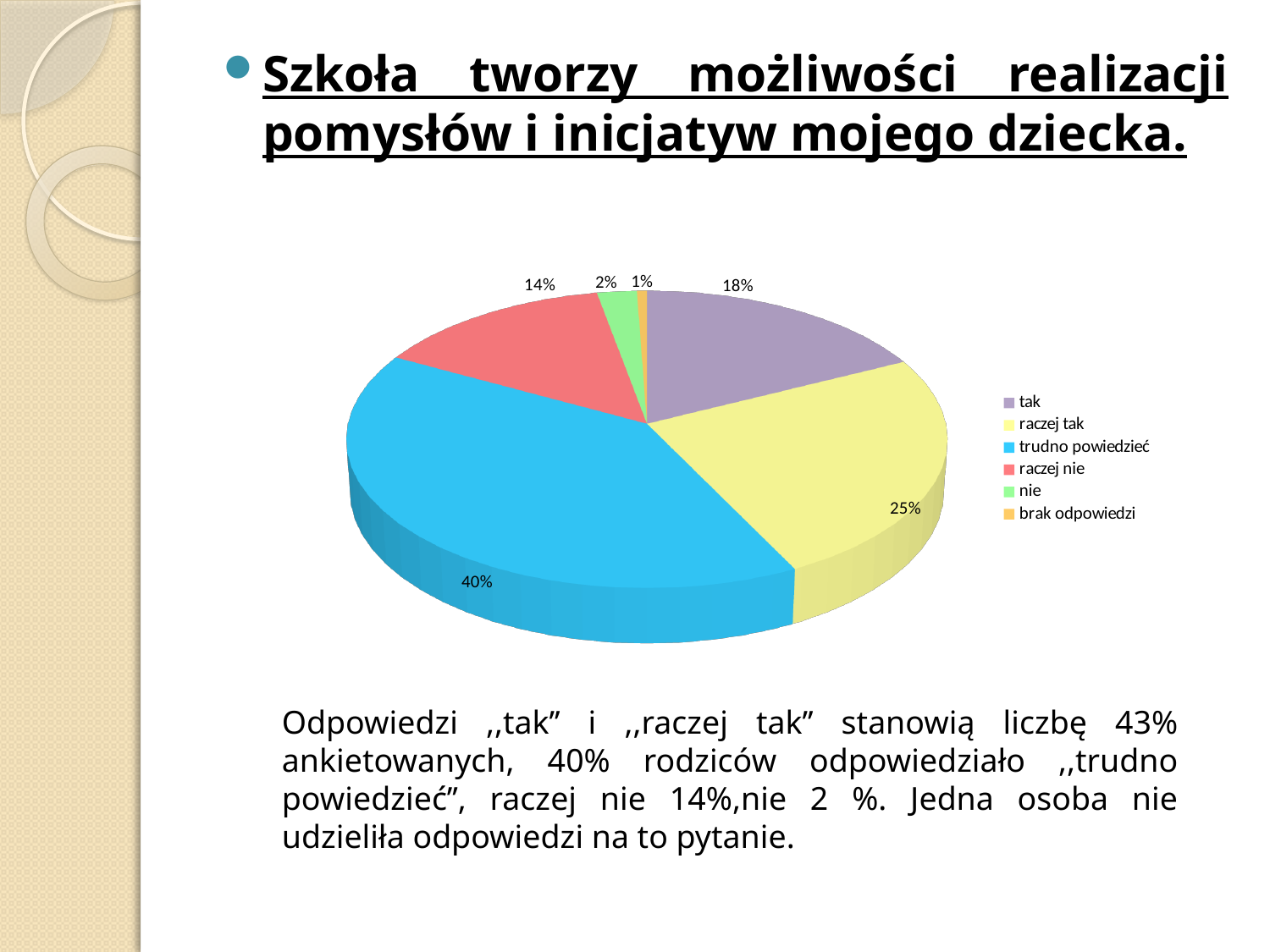
Which answer category has the largest share of the pie? trudno powiedzieć What is the difference in percentage points between "trudno powiedzieć" and "raczej tak"? 15 Which is larger, the share for "tak" or the share for "raczej nie"? tak How many categories does the legend list? 6 What percentage of respondents answered "trudno powiedzieć"? 40% What percentage is shown for "brak odpowiedzi"? 1% What percentage of respondents answered "nie"? 2% What kind of chart is shown on the slide? pie chart Which answer category has the smallest share of the pie? brak odpowiedzi What percentage of respondents answered "tak"? 18% What percentage of respondents answered "raczej nie"? 14% What percentage of respondents answered "raczej tak"? 25%